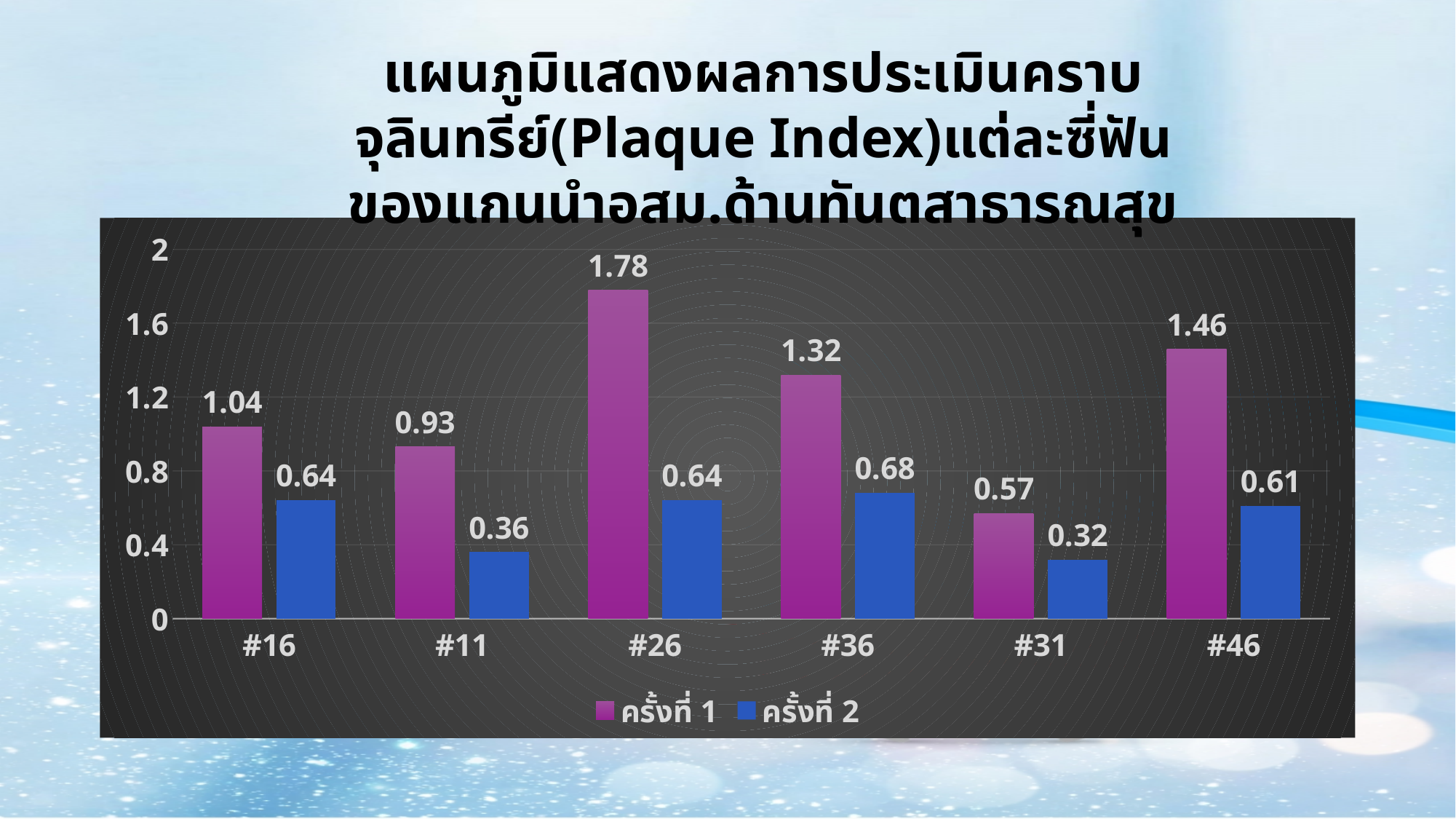
Which is larger at #36: ครั้งที่ 1 or ครั้งที่ 2? ครั้งที่ 1 What is the value for ครั้งที่ 1 at #46? 1.46 Which tooth has the highest value for ครั้งที่ 1? #26 What kind of chart is shown on the slide? bar chart Is the value for ครั้งที่ 1 at #31 greater or less than 0.8? less Which tooth has the lowest value for ครั้งที่ 2? #31 What colour are the bars for ครั้งที่ 2? blue What is the difference between ครั้งที่ 1 and ครั้งที่ 2 at #26? 1.14 How many series does the legend list? 2 How many teeth are shown on the x axis? 6 What is the value for ครั้งที่ 1 at #26? 1.78 What is the value for ครั้งที่ 2 at #11? 0.36